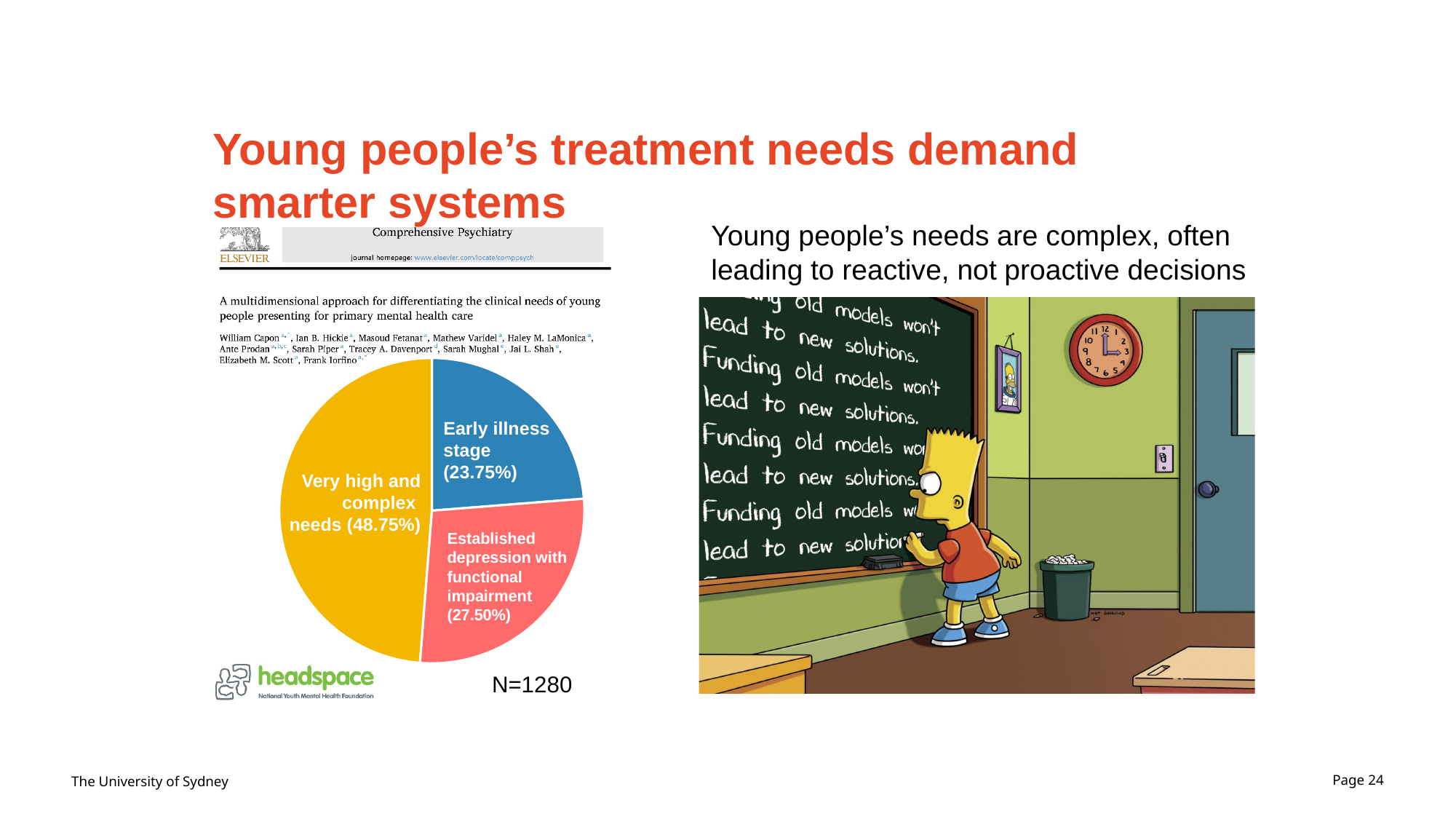
Which is larger: the 'Established depression with functional impairment' slice or the 'Early illness stage' slice? Established depression with functional impairment What is the sample size (N) shown beneath the pie chart? N=1280 What share of the pie is labelled 'Established depression with functional impairment'? 27.50% What is the difference in percentage points between the 'Established depression with functional impairment' slice and the 'Early illness stage' slice? 3.75 percentage points What share of the pie is labelled 'Very high and complex needs'? 48.75% What colour is the 'Very high and complex needs' slice of the pie chart? Yellow Which slice of the pie chart is the largest? Very high and complex needs What kind of chart is shown on the slide? Pie chart What is the difference in percentage points between the 'Very high and complex needs' slice and the 'Early illness stage' slice? 25 percentage points How many slices does the pie chart have? 3 Which slice of the pie chart is the smallest? Early illness stage What share of the pie is labelled 'Early illness stage'? 23.75%